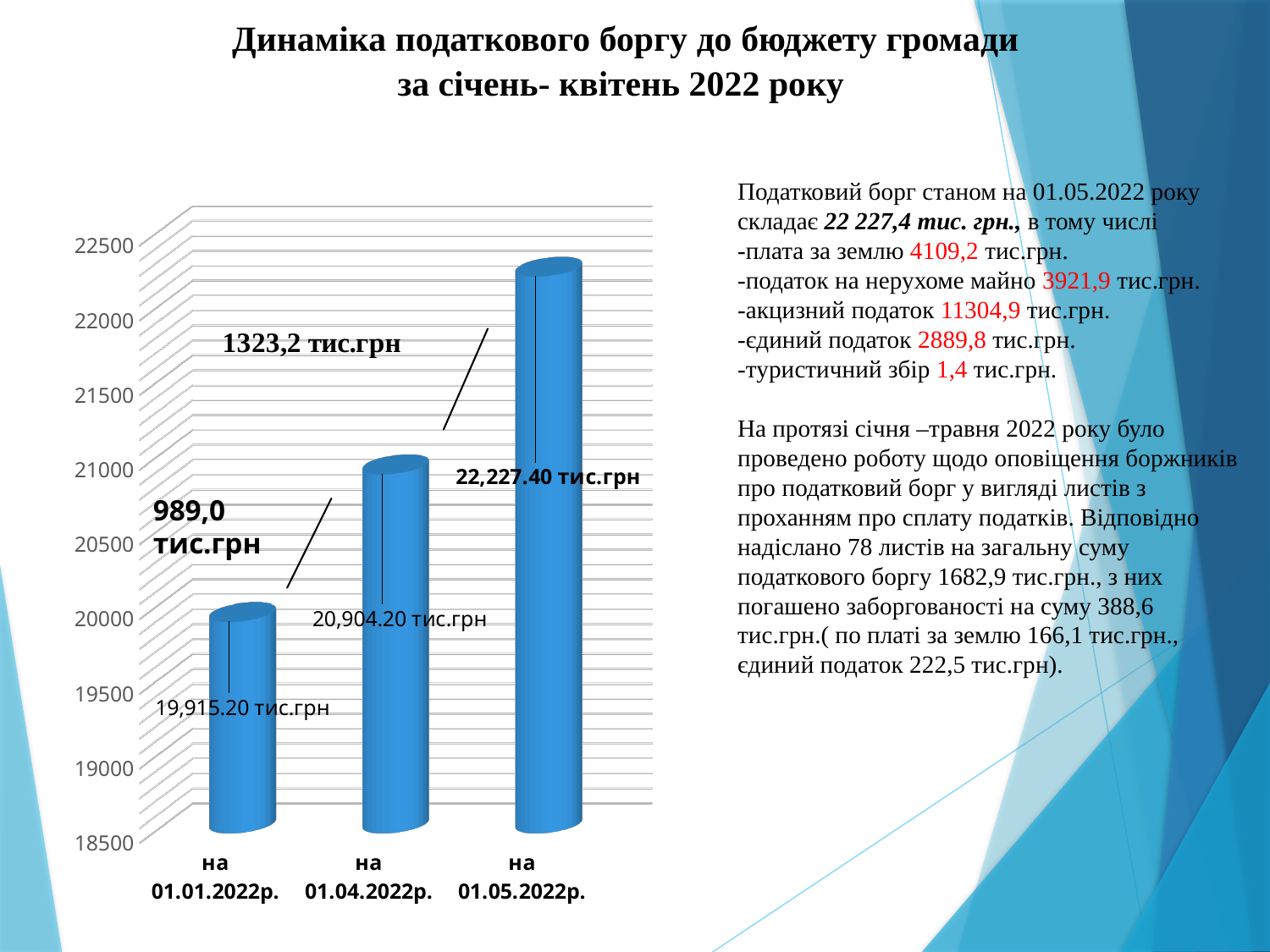
Which is larger, the value for на 01.04.2022р. or the value for на 01.05.2022р.? на 01.05.2022р. What is the value of the bar for на 01.05.2022р.? 22,227.40 тис.грн Which date has the highest tax debt value on the chart? на 01.05.2022р. Which date has the lowest tax debt value on the chart? на 01.01.2022р. What is the value of the bar for на 01.04.2022р.? 20,904.20 тис.грн What is the difference between the values for на 01.04.2022р. and на 01.01.2022р.? 989,0 тис.грн How many bars are shown on the chart? 3 Do the values rise or fall from на 01.01.2022р. to на 01.05.2022р.? rise What is the difference between the values for на 01.05.2022р. and на 01.04.2022р.? 1323,2 тис.грн What kind of chart is shown on the slide? bar chart Is the value for на 01.01.2022р. greater or less than 20000? less What is the value of the bar for на 01.01.2022р.? 19,915.20 тис.грн